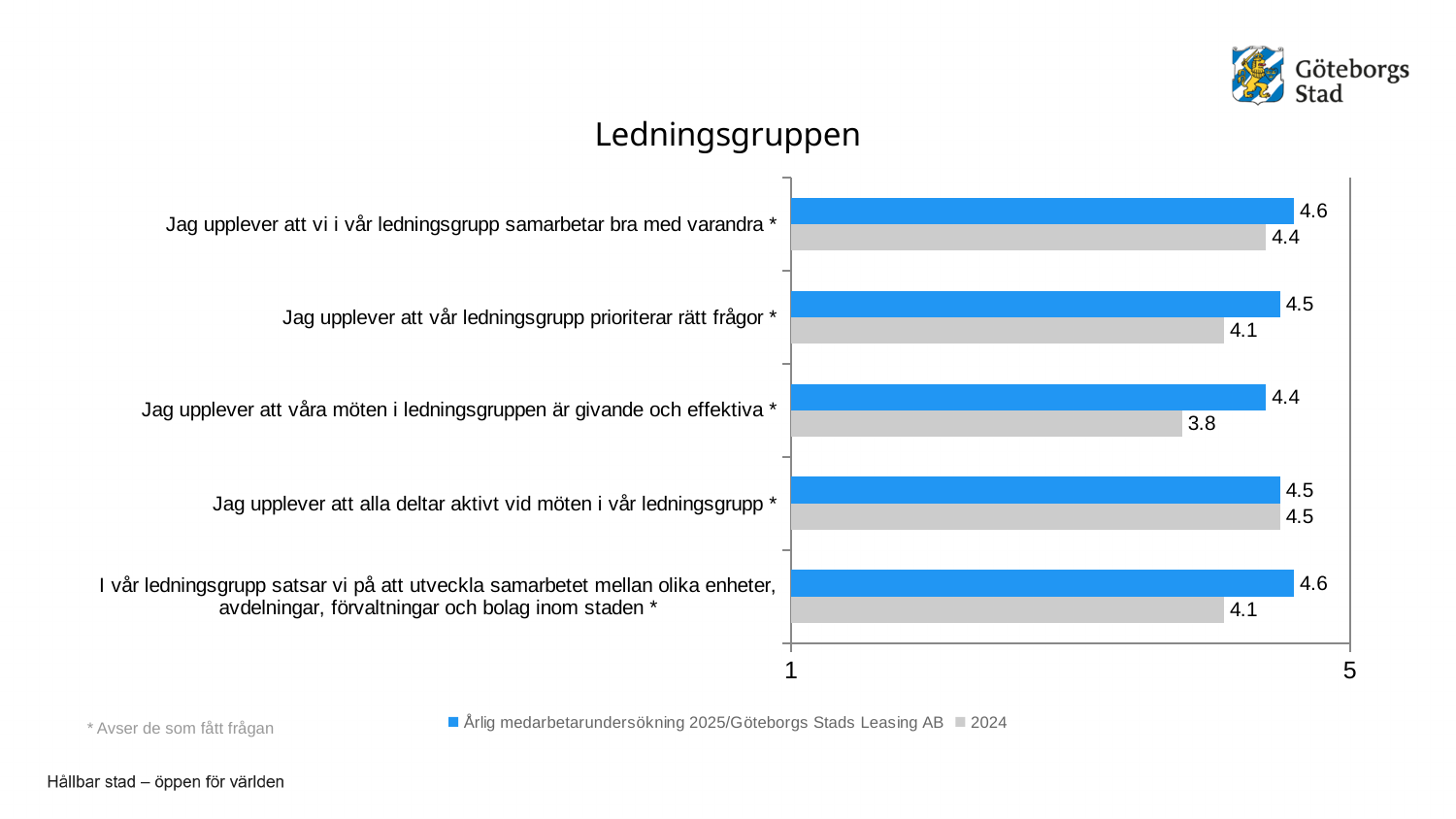
What is the difference between the 2025 and 2024 values for "Jag upplever att våra möten i ledningsgruppen är givande och effektiva"? 0.6 What is the 2024 value for "Jag upplever att våra möten i ledningsgruppen är givande och effektiva"? 3.8 How many categories are shown in the chart? 5 Which category has the lowest 2025 value? Jag upplever att våra möten i ledningsgruppen är givande och effektiva What is the 2024 value for "Jag upplever att vår ledningsgrupp prioriterar rätt frågor"? 4.1 How many series does the legend list? 2 What kind of chart is shown on the slide? Bar chart What is the difference between the 2025 and 2024 values for "I vår ledningsgrupp satsar vi på att utveckla samarbetet mellan olika enheter, avdelningar, förvaltningar och bolag inom staden"? 0.5 What is the 2025 value for "Jag upplever att vi i vår ledningsgrupp samarbetar bra med varandra"? 4.6 For "Jag upplever att alla deltar aktivt vid möten i vår ledningsgrupp", is the 2025 value larger than, smaller than, or equal to the 2024 value? equal Which category has the lowest 2024 value? Jag upplever att våra möten i ledningsgruppen är givande och effektiva Which is larger: the 2024 value for "Jag upplever att vi i vår ledningsgrupp samarbetar bra med varandra" or the 2024 value for "Jag upplever att vår ledningsgrupp prioriterar rätt frågor"? Jag upplever att vi i vår ledningsgrupp samarbetar bra med varandra